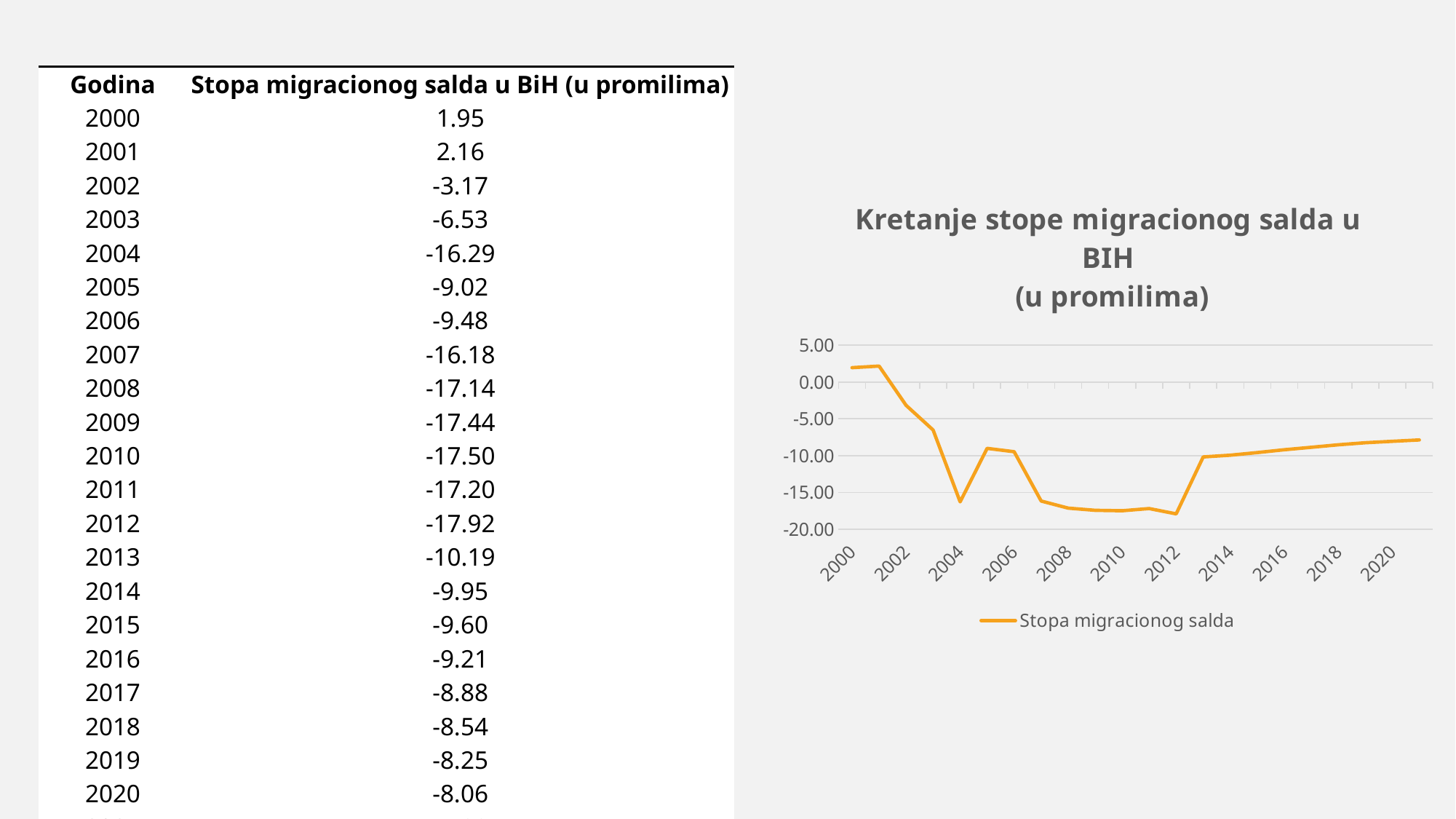
What is the value of the migration balance rate for 2004? -16.29 In which year is the migration balance rate lowest? 2012 What is the title of the chart? Kretanje stope migracionog salda u BIH (u promilima) How many series does the chart's legend list? 1 Does the migration balance rate rise or fall from 2013 to 2020? rise What is the difference between the values for 2001 and 2000? 0.21 What kind of chart is shown on the slide? line chart Which year has the larger migration balance rate, 2004 or 2005? 2005 What is the value of the migration balance rate for 2020? -8.06 What is the legend entry of the chart? Stopa migracionog salda Is the value for 2013 greater or less than -15.00? greater Is the value for 2004 greater or less than -15.00? less